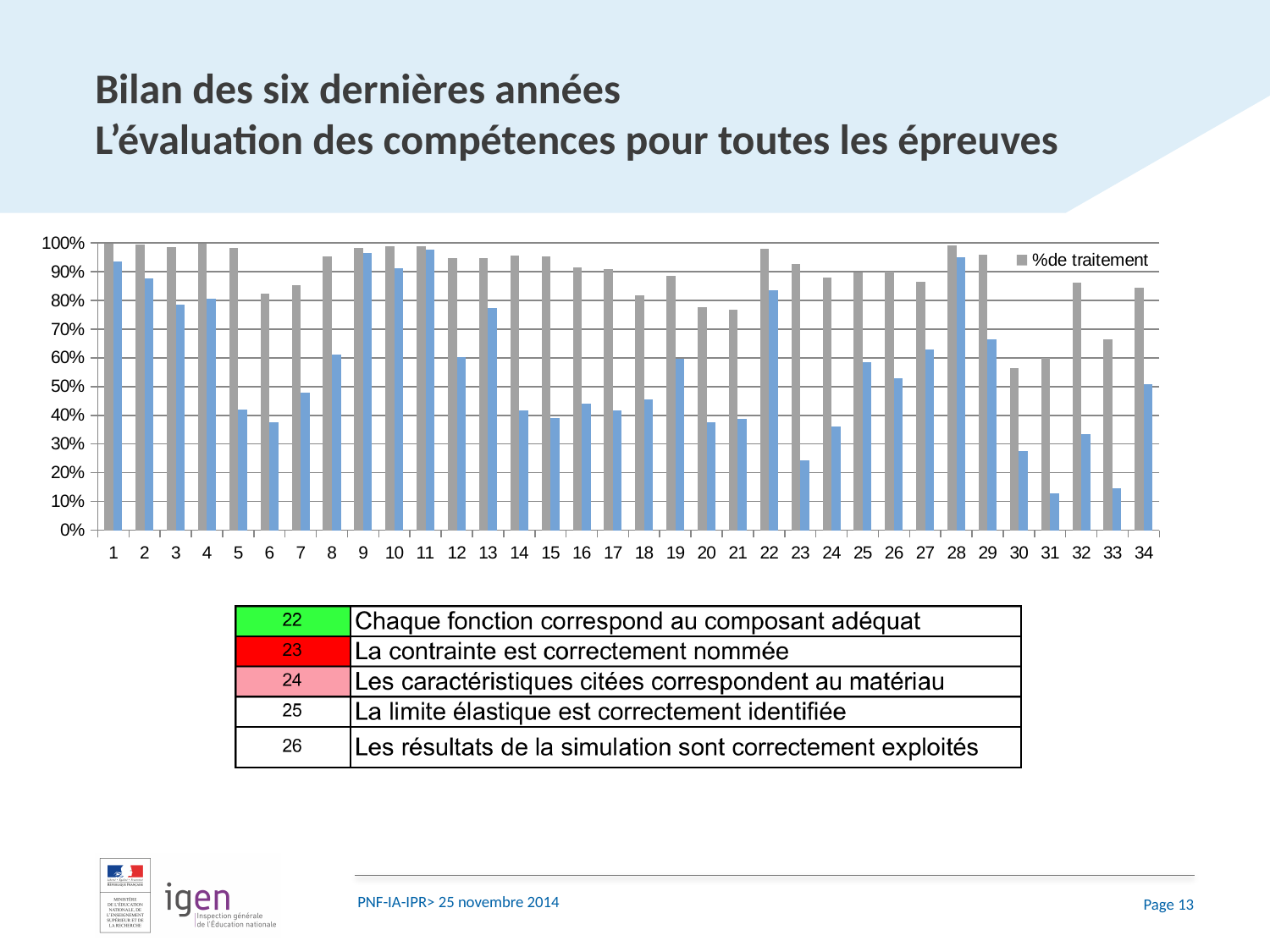
Is the blue bar for category 23 greater or less than 30%? less What kind of chart is shown on the slide? bar chart Which is larger, the blue bar for category 22 or the blue bar for category 23? category 22 Which is larger, the "%de traitement" bar for category 1 or for category 30? category 1 Is the blue bar for category 31 greater or less than 20%? less Is the "%de traitement" bar for category 33 greater or less than 60%? greater What colour are the bars of the "%de traitement" series? grey What is the name of the series listed in the chart's legend? %de traitement How many categories are shown along the x axis of the chart? 34 How many series does the chart's legend list? 1